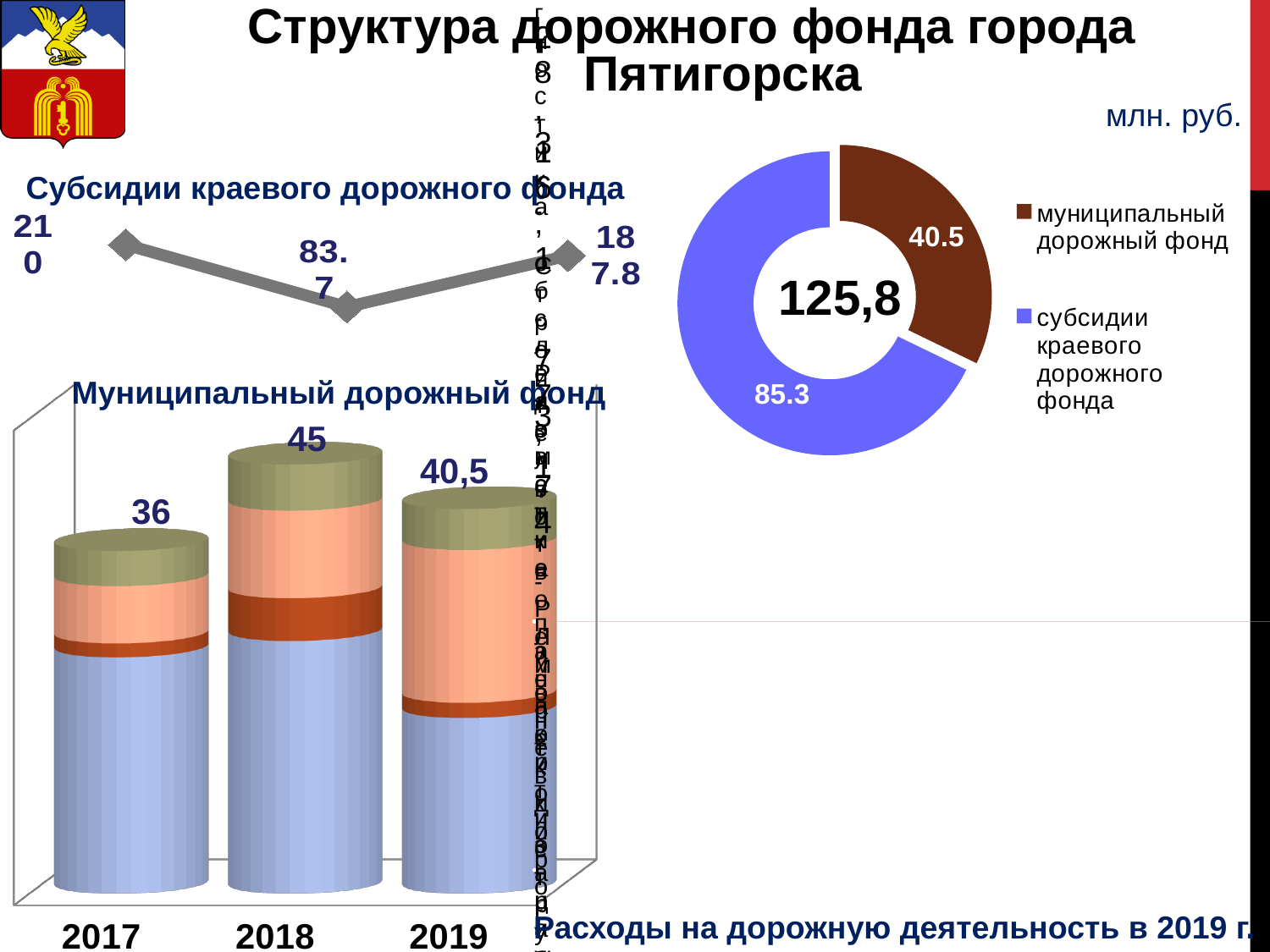
In the bar chart 'Муниципальный дорожный фонд', what is the total value for 2019? 40,5 In the line chart 'Субсидии краевого дорожного фонда', what is the lowest value shown? 83.7 In the donut chart 'Расходы на дорожную деятельность в 2019 г.', what is the value for 'субсидии краевого дорожного фонда'? 85.3 In the donut chart 'Расходы на дорожную деятельность в 2019 г.', how many entries does the legend list? 2 In the bar chart 'Муниципальный дорожный фонд', what is the total value for 2018? 45 In the bar chart 'Муниципальный дорожный фонд', what is the difference between the totals for 2018 and 2017? 9 In the bar chart 'Муниципальный дорожный фонд', which year has the highest total? 2018 In the bar chart 'Муниципальный дорожный фонд', which year has the lowest total? 2017 In the line chart 'Субсидии краевого дорожного фонда', what is the highest value shown? 210 In the bar chart 'Муниципальный дорожный фонд', how many years are shown on the x axis? 3 What kind of chart is 'Муниципальный дорожный фонд'? bar chart In the donut chart 'Расходы на дорожную деятельность в 2019 г.', what total is shown in the centre? 125,8